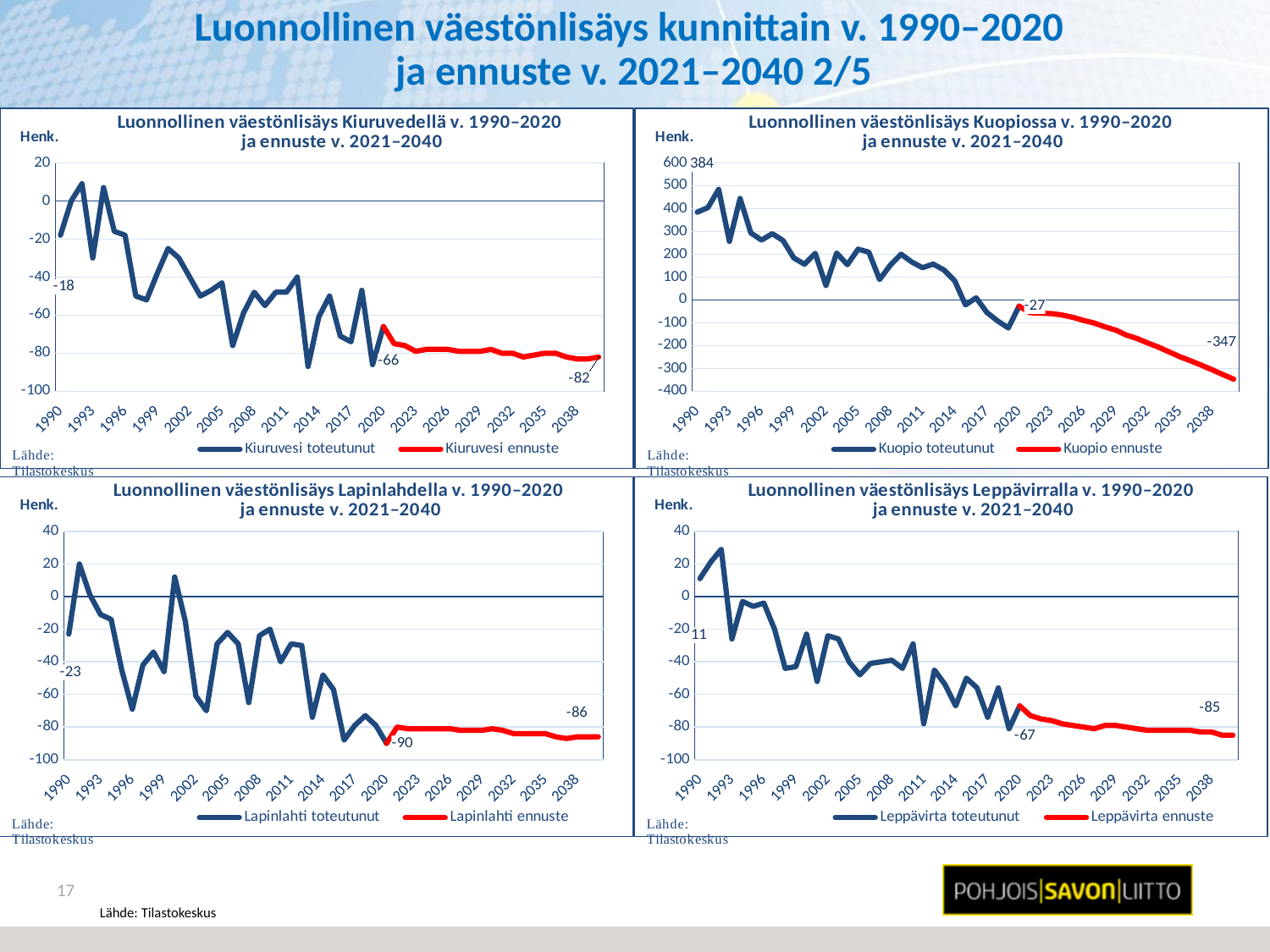
In the Kuopio chart (top right), what is the labelled forecast value for 2040? -347 In the Kiuruvesi chart (top left), what is the labelled forecast value for 2040? -82 In the Kuopio chart (top right), what is the difference between the 1990 value (384) and the 2020 value (-27)? 411 In the Leppävirta chart (bottom right), which labelled value is larger: the 2020 value or the 2040 forecast value? 2020 value (-67) In the Kuopio chart (top right), does the forecast line rise or fall from 2021 to 2040? Fall In the Kuopio chart (top right), what is the labelled value for 1990? 384 In the Kiuruvesi chart (top left), what colour is the forecast (ennuste) line? Red In the Leppävirta chart (bottom right), what is the labelled value for 1990? 11 How many series does the legend of the Lapinlahti chart (bottom left) list? 2 What type of chart is the Kuopio chart (top right)? Line chart In the Lapinlahti chart (bottom left), what is the labelled value for 2020? -90 In the Kiuruvesi chart (top left), what is the labelled value for 1990? -18